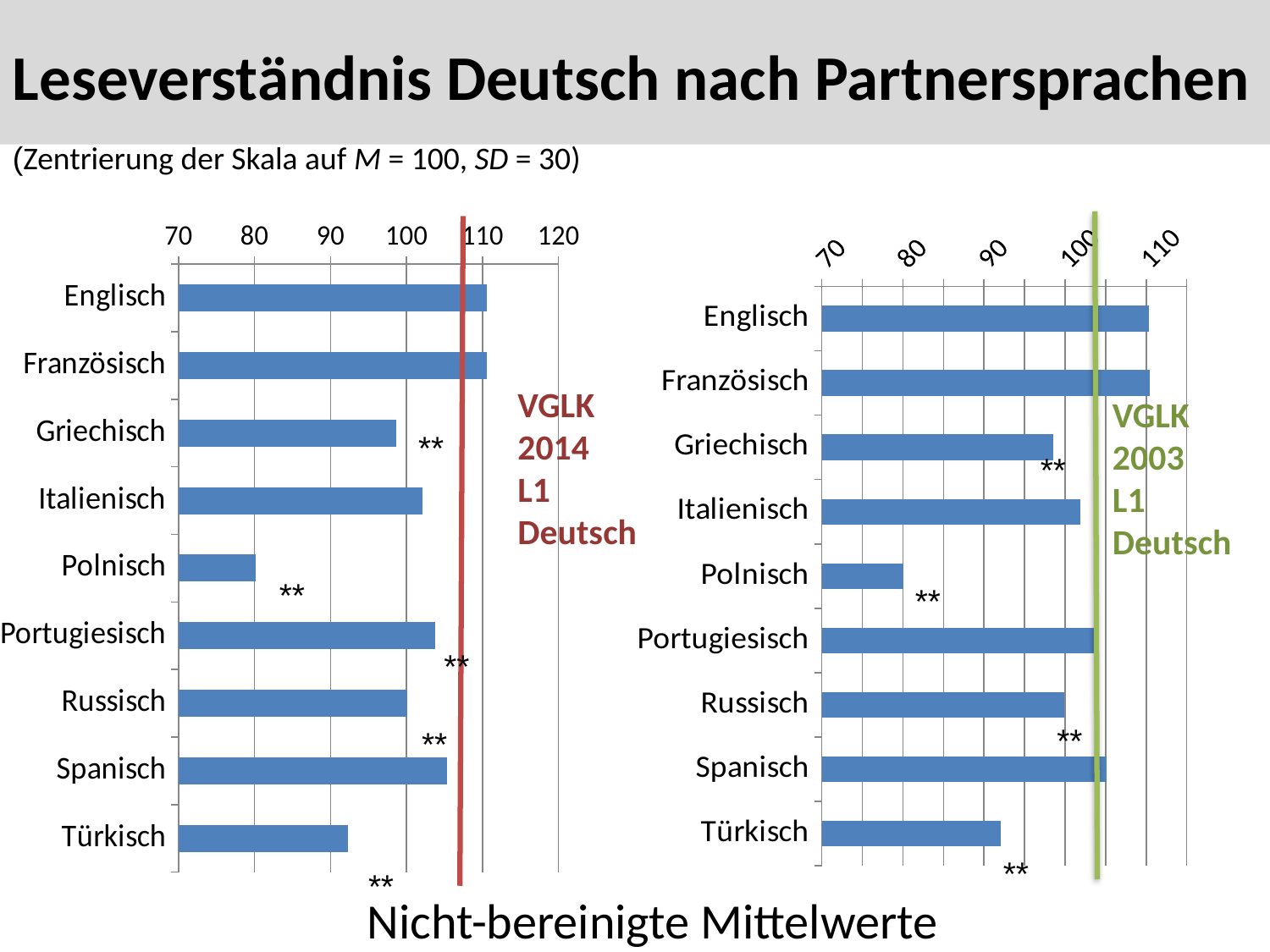
In the right chart (VGLK 2003), which is larger, the value for Polnisch or the value for Italienisch? Italienisch What caption appears below the two charts? Nicht-bereinigte Mittelwerte In the left chart (VGLK 2014), is the value for Türkisch greater or less than 100? less In the right chart (VGLK 2003), is the value for Englisch greater or less than 100? greater What label is written next to the red vertical line in the left chart? VGLK 2014 L1 Deutsch In the right chart (VGLK 2003), is the value for Türkisch greater or less than 100? less What kind of chart is the left chart (VGLK 2014)? bar chart In the right chart (VGLK 2003), which language has the lowest value? Polnisch In the left chart (VGLK 2014), which is larger, the value for Spanisch or the value for Türkisch? Spanisch How many language categories are shown in the right chart (VGLK 2003)? 9 In the left chart (VGLK 2014), which language has the lowest value? Polnisch